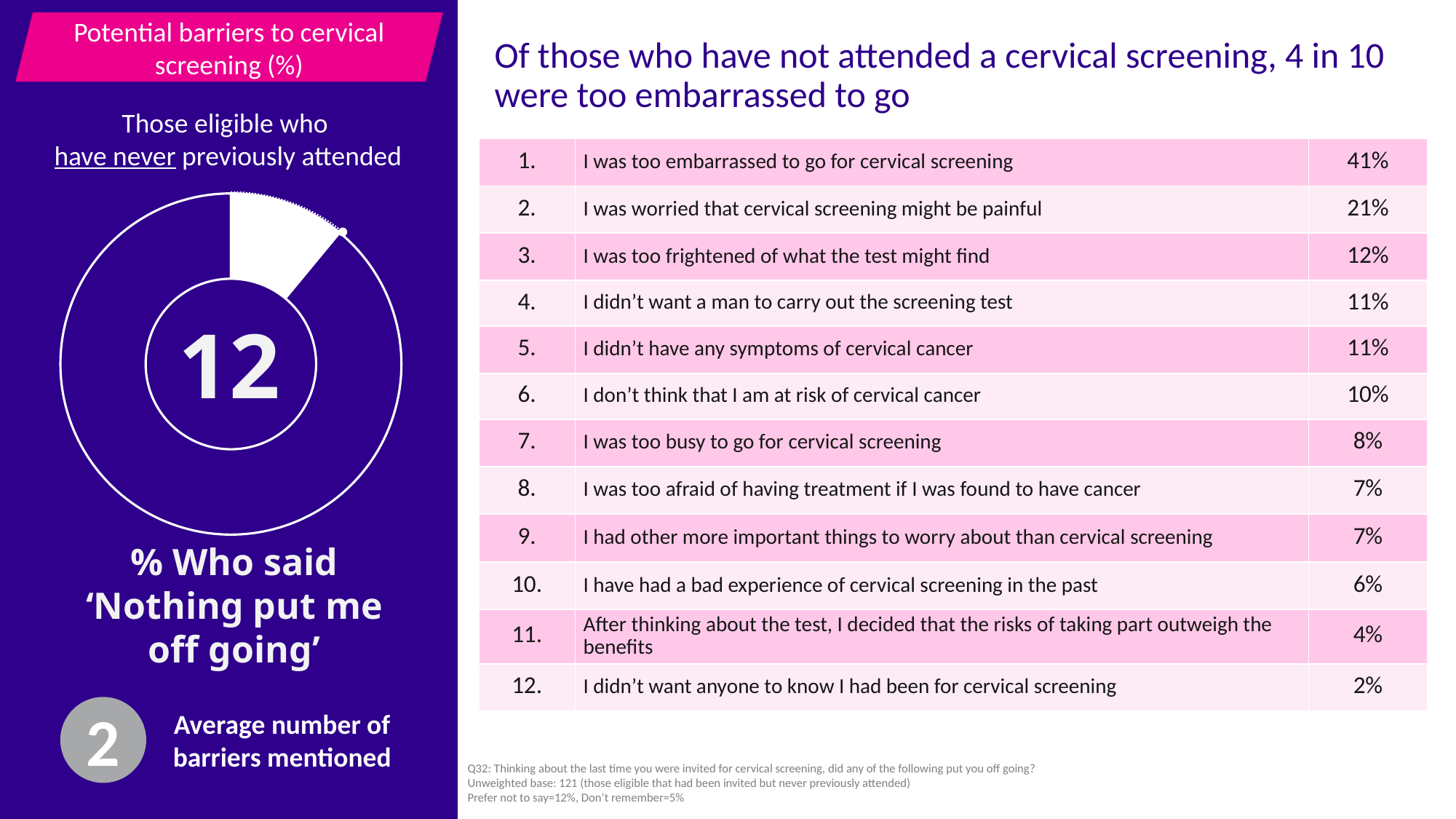
How many barriers are listed in the table on the right of the slide? 12 In the table of barriers, what percentage said 'I was too embarrassed to go for cervical screening'? 41% In the table of barriers, which barrier has the lowest percentage? I didn't want anyone to know I had been for cervical screening In the table of barriers, what is the difference between 'I was too embarrassed to go for cervical screening' and 'I was worried that cervical screening might be painful'? 20% What does the highlighted slice of the donut chart represent? % Who said 'Nothing put me off going' What is the average number of barriers mentioned, as shown in the grey circle on the left panel? 2 What is the title of the left panel containing the donut chart? Potential barriers to cervical screening (%) What value is shown in the centre of the donut chart on the left of the slide? 12 In the table of barriers, which is larger: 'I was too frightened of what the test might find' or 'I was too busy to go for cervical screening'? I was too frightened of what the test might find What kind of chart is shown on the left of the slide under 'Those eligible who have never previously attended'? Donut (pie) chart Is the highlighted share in the donut chart greater or less than 50%? less What percentage of those who have never previously attended said 'Nothing put me off going', according to the donut chart? 12